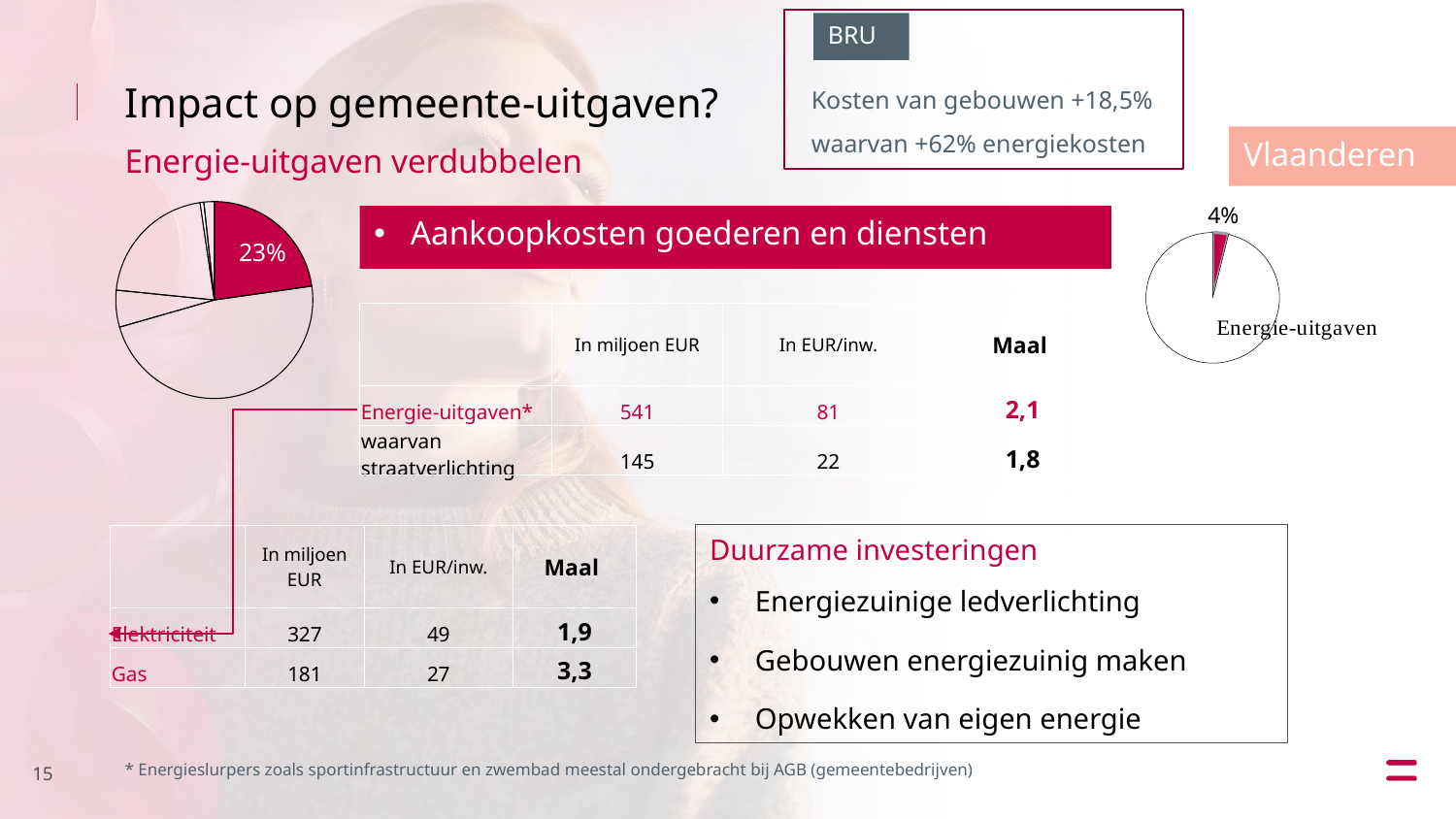
In the right pie chart, what percentage is printed for the highlighted slice? 4% What is the difference in percentage points between the highlighted slice of the left pie chart (23%) and the highlighted slice of the right pie chart (4%)? 19 percentage points How many pie charts are shown on the slide? 2 What colour is the highlighted slice in the left pie chart? red What kind of chart is shown on the left side of the slide, next to the 23% label? pie chart What kind of chart is shown on the right side of the slide, next to the 4% label? pie chart Which highlighted slice is larger: the 23% slice in the left pie chart or the 4% slice in the right pie chart? the 23% slice in the left pie chart In the left pie chart, what percentage is printed on the highlighted slice? 23% In the right pie chart, what is the label of the highlighted slice? Energie-uitgaven